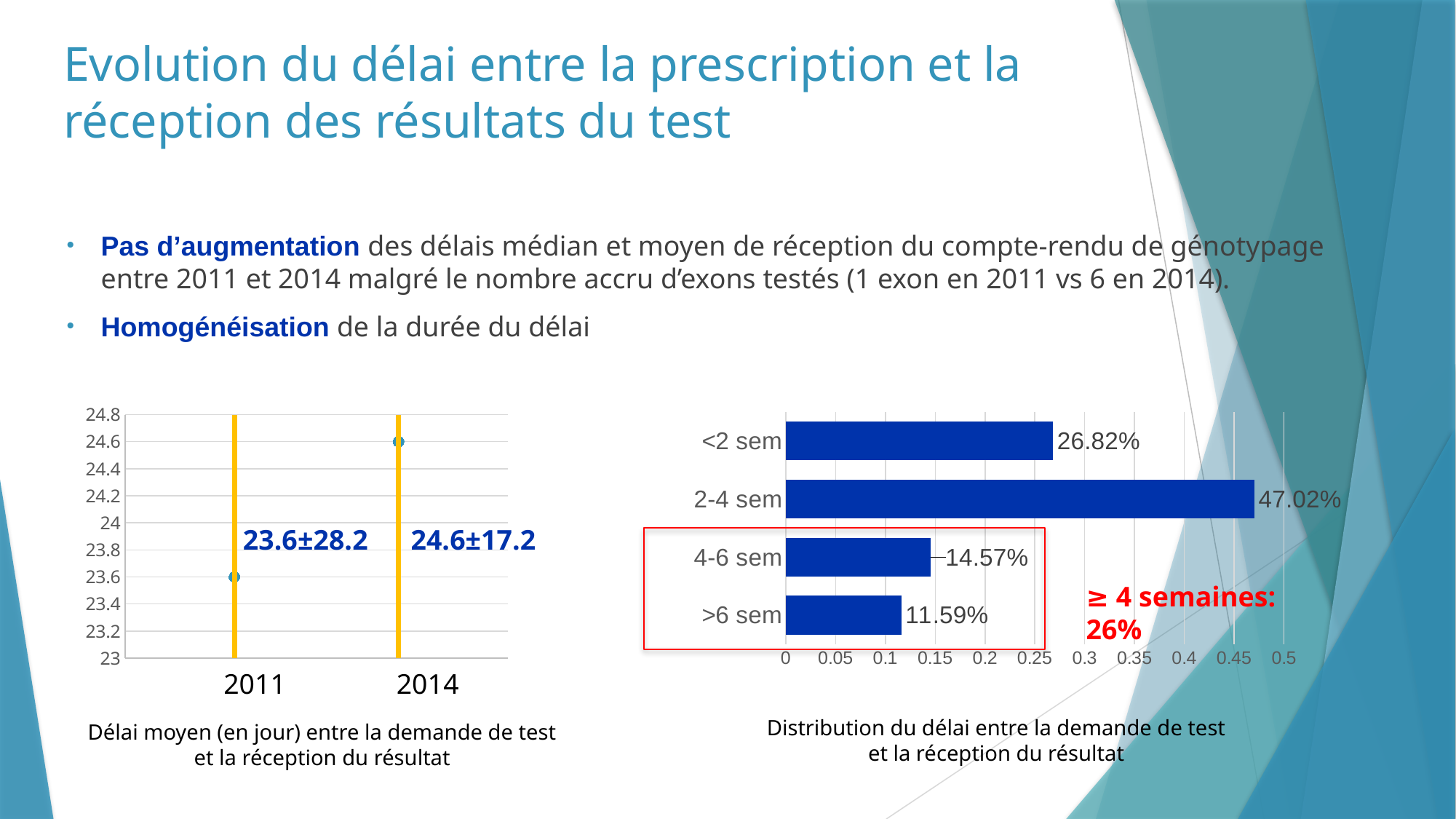
In the right-hand chart (Distribution du délai), what is the difference between the values for "2-4 sem" and "<2 sem"? 20.20% In the right-hand chart (Distribution du délai), which category has the lowest value? >6 sem What kind of chart is the right-hand chart (Distribution du délai)? Bar chart In the right-hand chart (Distribution du délai), which is larger, the value for "4-6 sem" or the value for ">6 sem"? 4-6 sem In the right-hand chart (Distribution du délai entre la demande de test et la réception du résultat), what is the value for the "2-4 sem" category? 47.02% In the left-hand chart (Délai moyen en jour), what is the mean delay value plotted for 2014? 24.6 In the right-hand chart (Distribution du délai), what is the value for the ">6 sem" category? 11.59% In the left-hand chart (Délai moyen en jour), does the plotted value rise or fall from 2011 to 2014? Rise In the right-hand chart (Distribution du délai), which category has the highest value? 2-4 sem In the right-hand chart (Distribution du délai), what is the value for the "<2 sem" category? 26.82% How many categories are shown in the right-hand chart (Distribution du délai)? 4 In the left-hand chart (Délai moyen en jour), what is the mean delay value plotted for 2011? 23.6